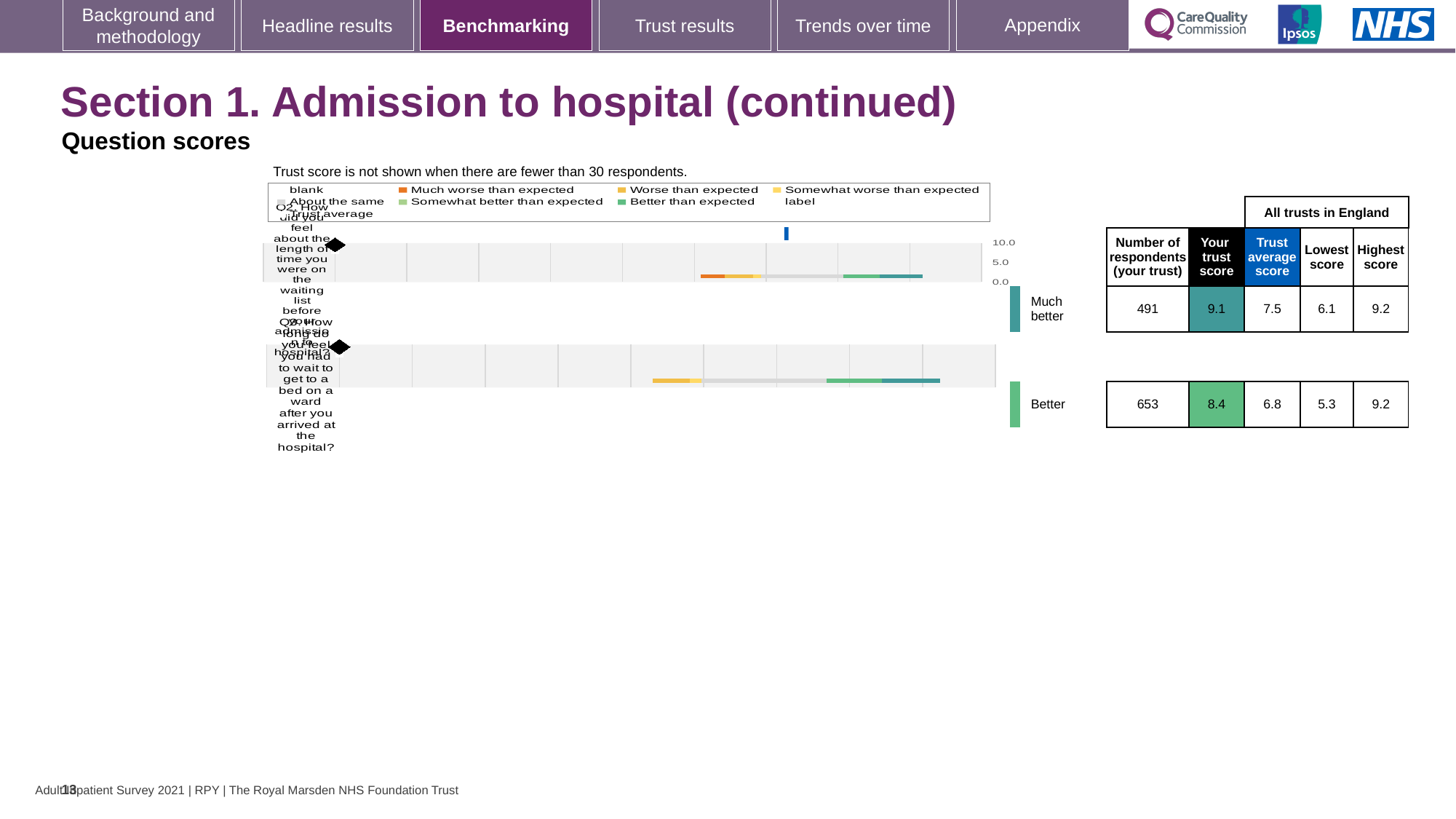
What is the difference between the highest and lowest scores across all trusts in England for Q2? 3.1 How many respondents from the trust answered Q3? 653 What is the lowest score across all trusts in England for Q3? 5.3 What benchmark rating is shown next to the bar for Q2? Much better Which question has the higher trust score, Q2 or Q3? Q2 What is the trust score for Q2 (length of time on the waiting list before admission)? 9.1 What benchmark rating is shown next to the bar for Q3? Better What kind of chart is used to show the question scores? Bar chart What is the trust average score across all trusts in England for Q2? 7.5 How many questions are plotted in the chart? 2 What is the difference between the trust score and the trust average score for Q3? 1.6 What is the trust score for Q3 (wait to get to a bed on a ward after arriving at the hospital)? 8.4